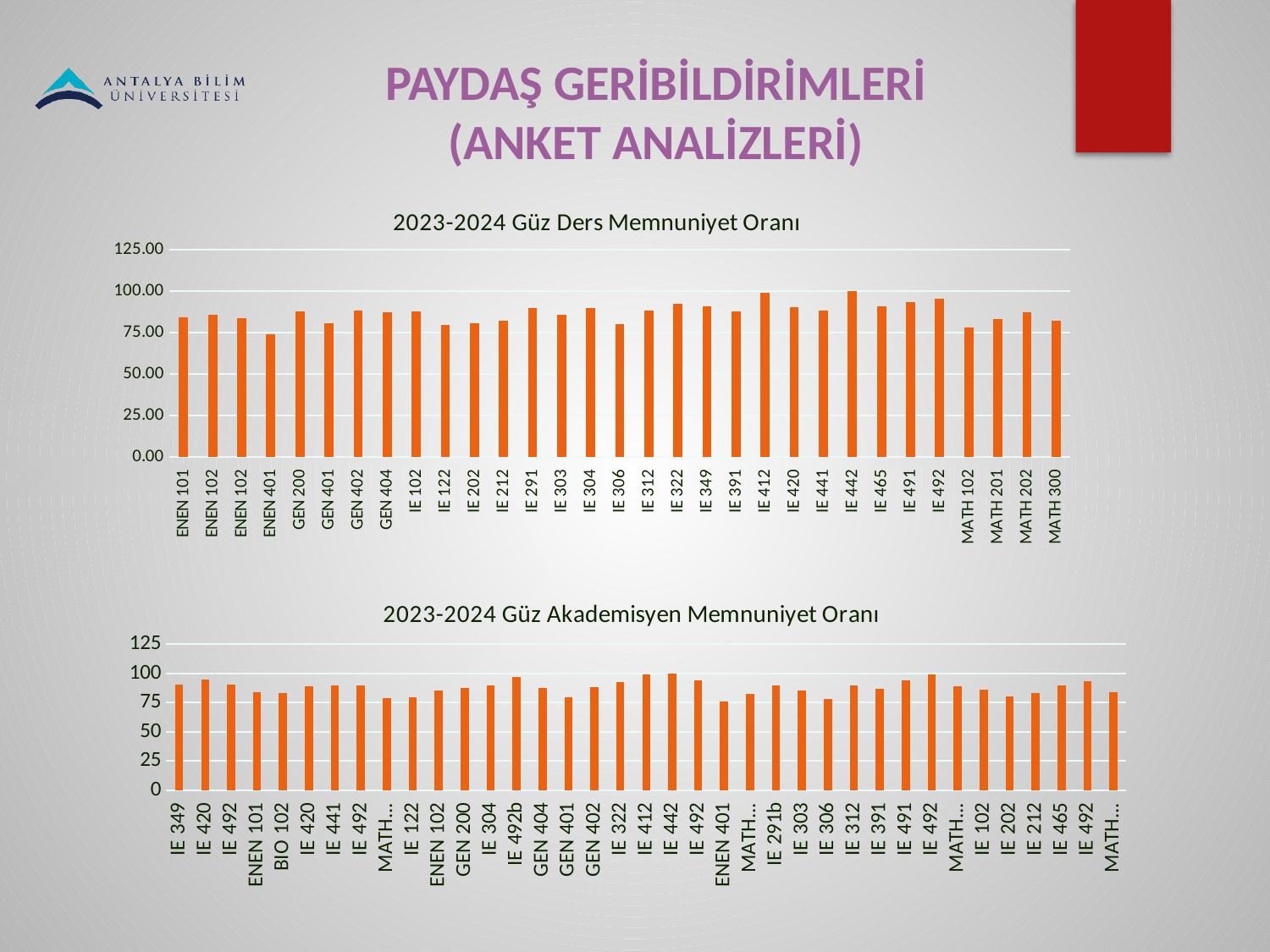
In the bottom chart (2023-2024 Güz Akademisyen Memnuniyet Oranı), is the value for BIO 102 greater or less than 75? greater What kind of chart is the top chart titled "2023-2024 Güz Ders Memnuniyet Oranı"? bar chart In the top chart (2023-2024 Güz Ders Memnuniyet Oranı), is the value for IE 412 greater or less than 75.00? greater In the top chart (2023-2024 Güz Ders Memnuniyet Oranı), which course has the lowest value? ENEN 401 What is the title of the bottom chart? 2023-2024 Güz Akademisyen Memnuniyet Oranı In the bottom chart (2023-2024 Güz Akademisyen Memnuniyet Oranı), which is larger, the value for IE 442 or the value for ENEN 401? IE 442 In the bottom chart (2023-2024 Güz Akademisyen Memnuniyet Oranı), is the value for IE 492b greater or less than 75? greater In the top chart (2023-2024 Güz Ders Memnuniyet Oranı), which is larger, the value for IE 412 or the value for IE 306? IE 412 In the top chart (2023-2024 Güz Ders Memnuniyet Oranı), how many course categories are shown on the x axis? 31 What is the highest value shown on the y axis of the bottom chart (2023-2024 Güz Akademisyen Memnuniyet Oranı)? 125 In the top chart (2023-2024 Güz Ders Memnuniyet Oranı), which is larger, the value for ENEN 401 or the value for GEN 200? GEN 200